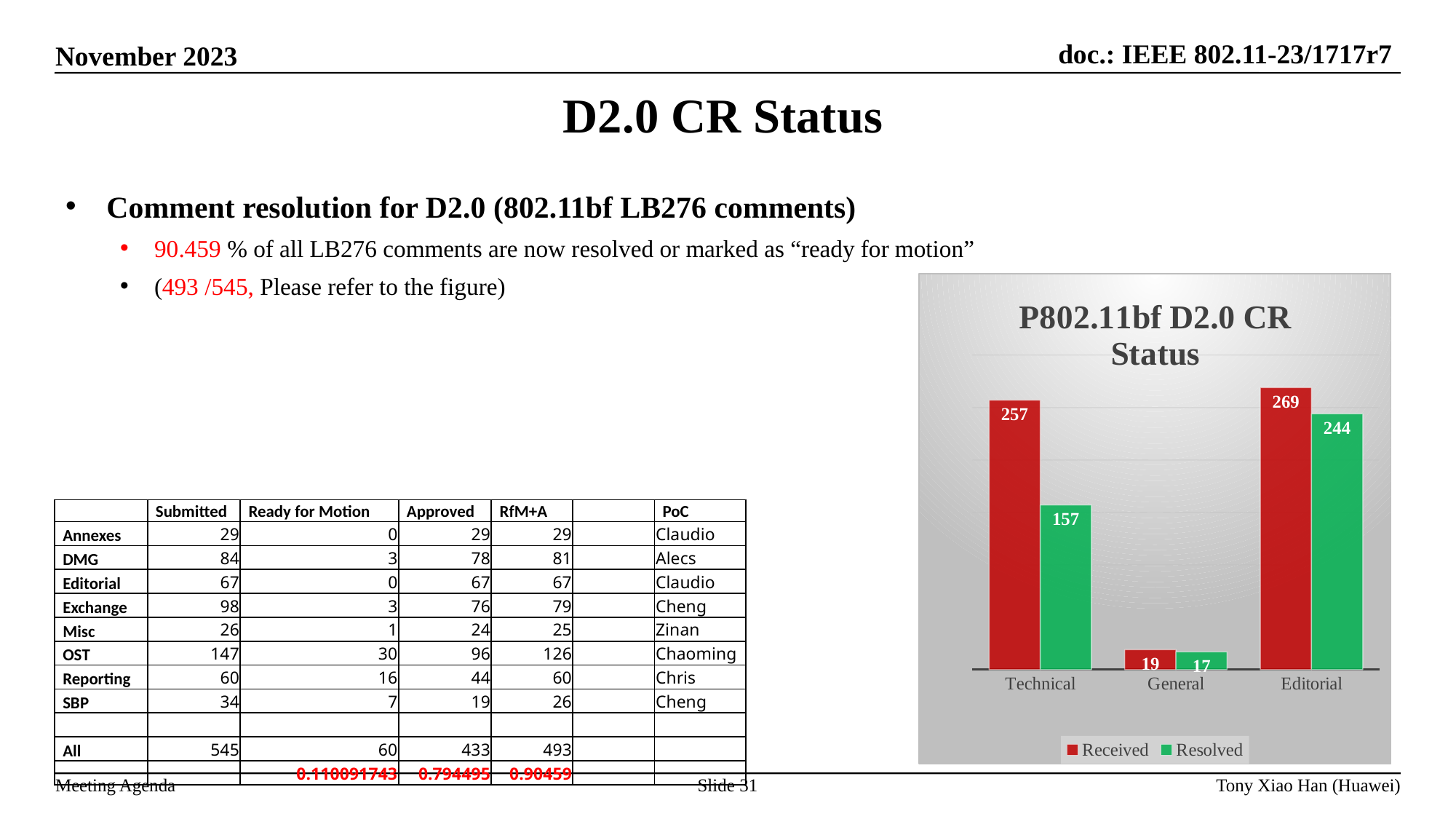
What is the title of the chart on the slide? P802.11bf D2.0 CR Status What is the difference between Received and Resolved for Technical? 100 What is the Resolved value for Editorial? 244 Which category has the highest Received value? Editorial How many categories are shown on the x axis of the chart? 3 How many series does the chart legend list? 2 What is the Received value for Technical? 257 Which category has the lowest Resolved value? General What type of chart is shown on the slide? bar chart What is the Resolved value for General? 17 Is the Resolved value for Technical larger or smaller than the Resolved value for Editorial? smaller Which colour represents the Resolved series in the chart? green